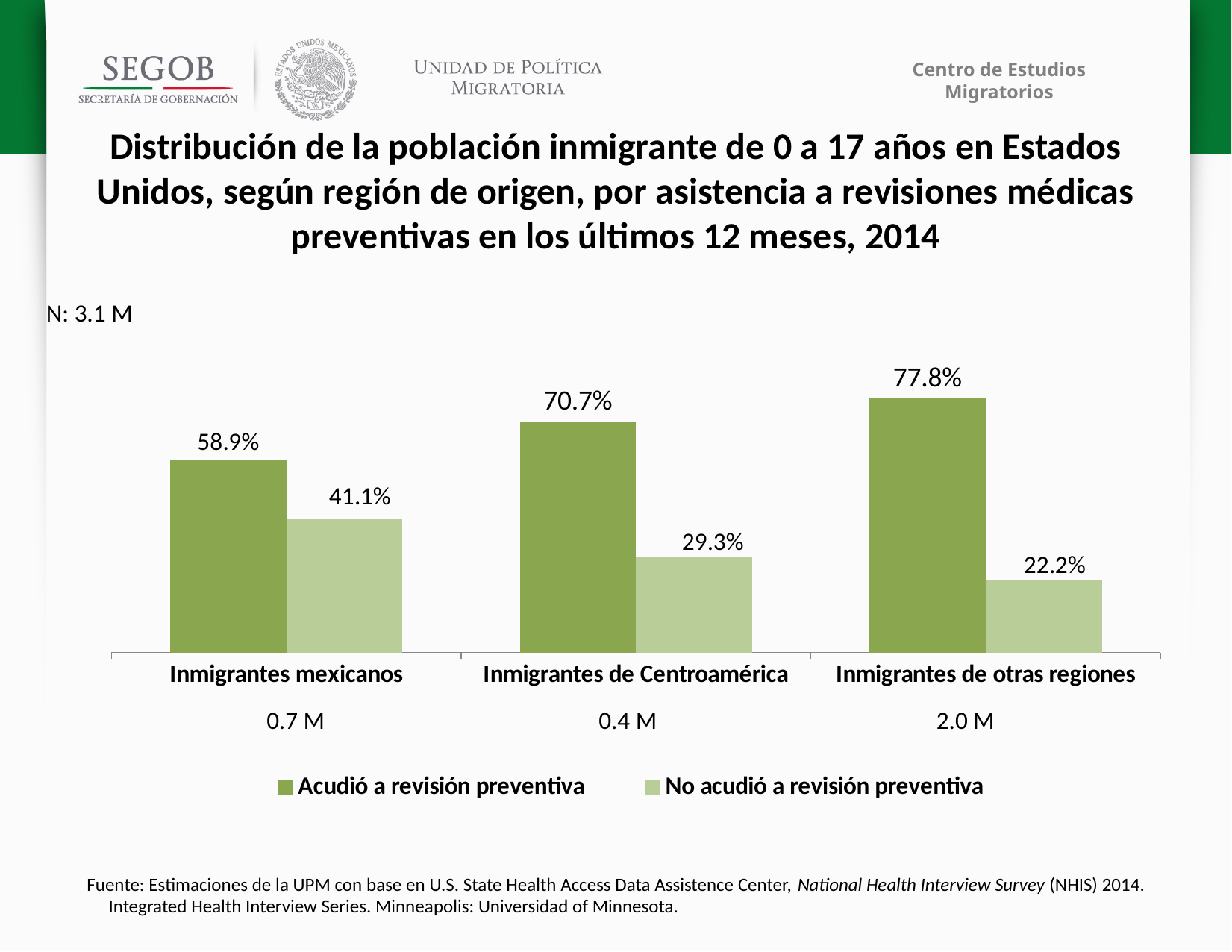
How many region categories are shown on the x axis? 3 What kind of chart is shown on the slide? Bar chart Does the 'Acudió a revisión preventiva' value rise or fall from left to right across the regions? Rise What percentage of Inmigrantes de otras regiones 'Acudió a revisión preventiva'? 77.8% What percentage of Inmigrantes mexicanos 'Acudió a revisión preventiva'? 58.9% Which region has the highest share of 'Acudió a revisión preventiva'? Inmigrantes de otras regiones What population size is shown below the Inmigrantes de otras regiones category? 2.0 M What percentage of Inmigrantes de Centroamérica 'No acudió a revisión preventiva'? 29.3% What is the difference between the 'Acudió a revisión preventiva' and 'No acudió a revisión preventiva' values for Inmigrantes mexicanos? 17.8% Which is larger: the 'No acudió a revisión preventiva' value for Inmigrantes mexicanos or for Inmigrantes de Centroamérica? Inmigrantes mexicanos How many series does the legend list? 2 Which region has the lowest share of 'No acudió a revisión preventiva'? Inmigrantes de otras regiones